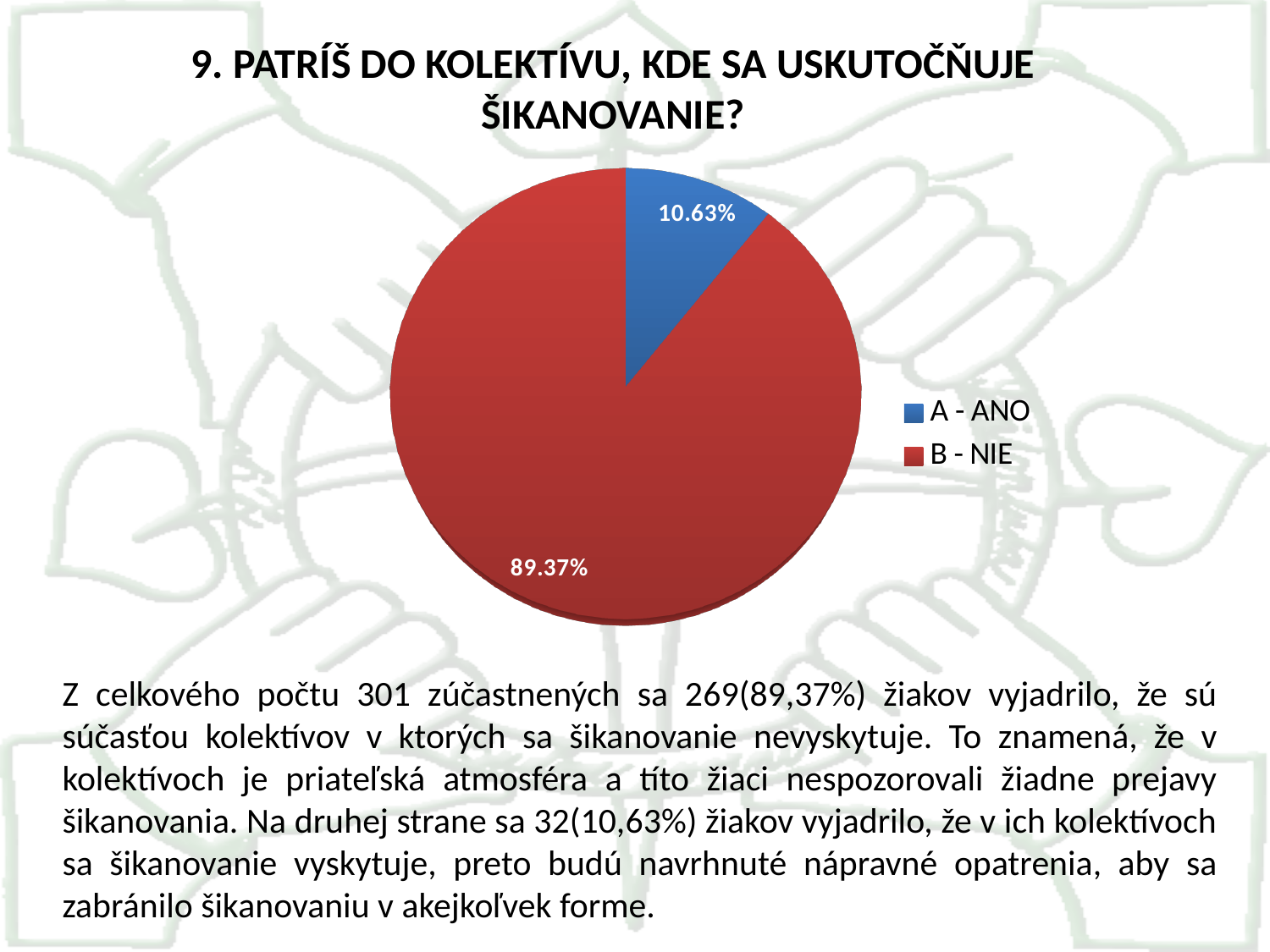
Which is larger, the slice for "A - ANO" or the slice for "B - NIE"? B - NIE Which slice of the pie is the smallest? A - ANO What share of the pie does the "B - NIE" slice represent? 89.37% What percentage is shown for the slice "A - ANO"? 10.63% What percentage is shown for the slice "B - NIE"? 89.37% How many slices does the pie chart have? 2 What is the title of the chart? 9. PATRÍŠ DO KOLEKTÍVU, KDE SA USKUTOČŇUJE ŠIKANOVANIE? How many entries does the legend list? 2 Which slice of the pie is the largest? B - NIE What colour is the "A - ANO" slice? blue What kind of chart is shown on the slide? pie chart What is the difference in percentage points between the "B - NIE" slice and the "A - ANO" slice? 78.74